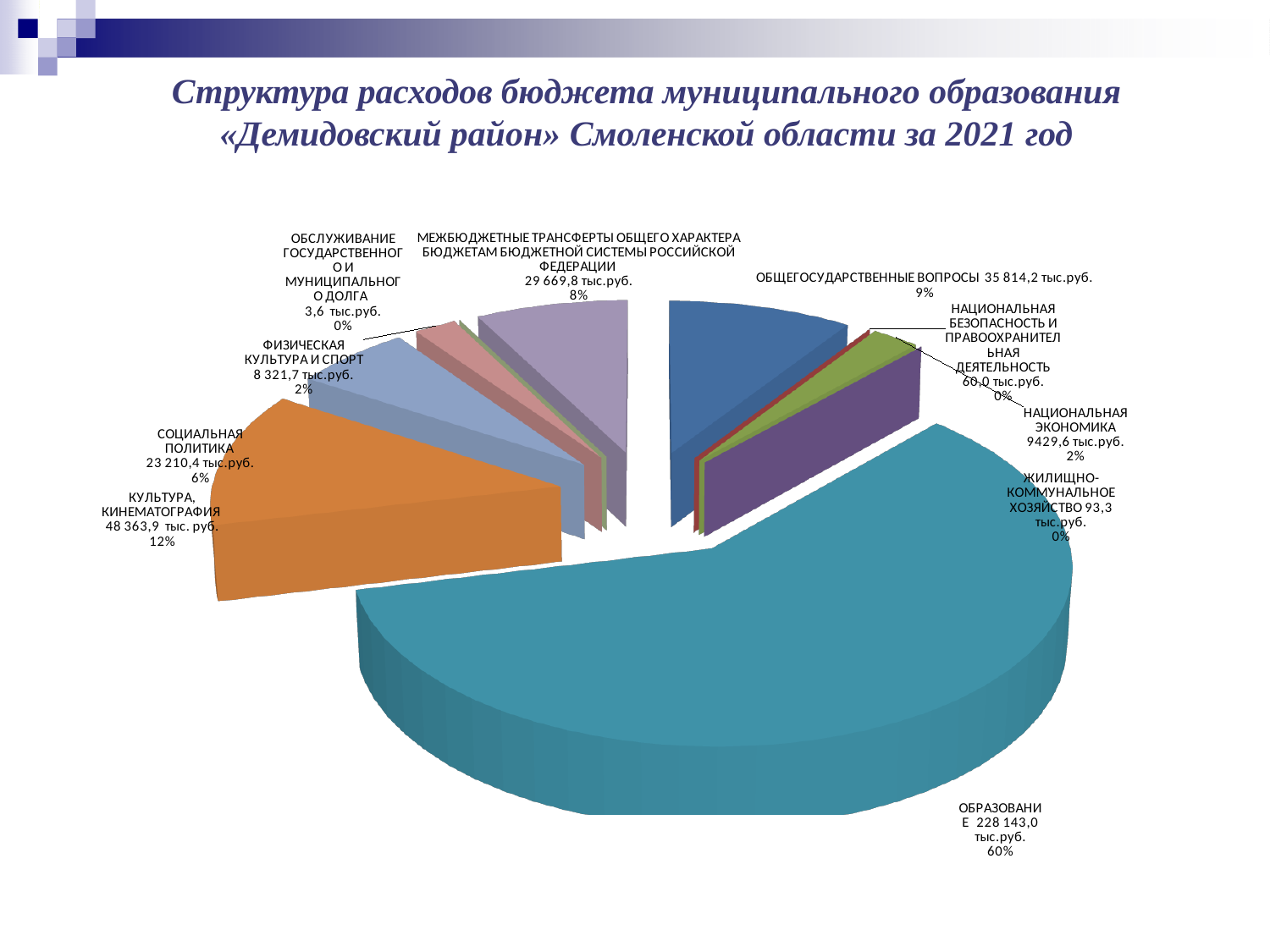
What percentage is shown for ОБЩЕГОСУДАРСТВЕННЫЕ ВОПРОСЫ? 9% Which category has the largest slice of the pie? ОБРАЗОВАНИЕ What is the value for КУЛЬТУРА, КИНЕМАТОГРАФИЯ? 48 363,9 тыс. руб. What share of the pie does ОБРАЗОВАНИЕ account for? 60% What is the value for ЖИЛИЩНО-КОММУНАЛЬНОЕ ХОЗЯЙСТВО? 93,3 тыс.руб. What is the value for ОБРАЗОВАНИЕ? 228 143,0 тыс.руб. What is the title of the chart on the slide? Структура расходов бюджета муниципального образования «Демидовский район» Смоленской области за 2021 год What is the value for НАЦИОНАЛЬНАЯ ЭКОНОМИКА? 9429,6 тыс.руб. How many categories (slices) does the pie chart show? 10 Which category has the smallest value? ОБСЛУЖИВАНИЕ ГОСУДАРСТВЕННОГО И МУНИЦИПАЛЬНОГО ДОЛГА Which is larger: СОЦИАЛЬНАЯ ПОЛИТИКА or МЕЖБЮДЖЕТНЫЕ ТРАНСФЕРТЫ ОБЩЕГО ХАРАКТЕРА БЮДЖЕТАМ БЮДЖЕТНОЙ СИСТЕМЫ РОССИЙСКОЙ ФЕДЕРАЦИИ? МЕЖБЮДЖЕТНЫЕ ТРАНСФЕРТЫ ОБЩЕГО ХАРАКТЕРА БЮДЖЕТАМ БЮДЖЕТНОЙ СИСТЕМЫ РОССИЙСКОЙ ФЕДЕРАЦИИ What type of chart is shown on the slide? pie chart